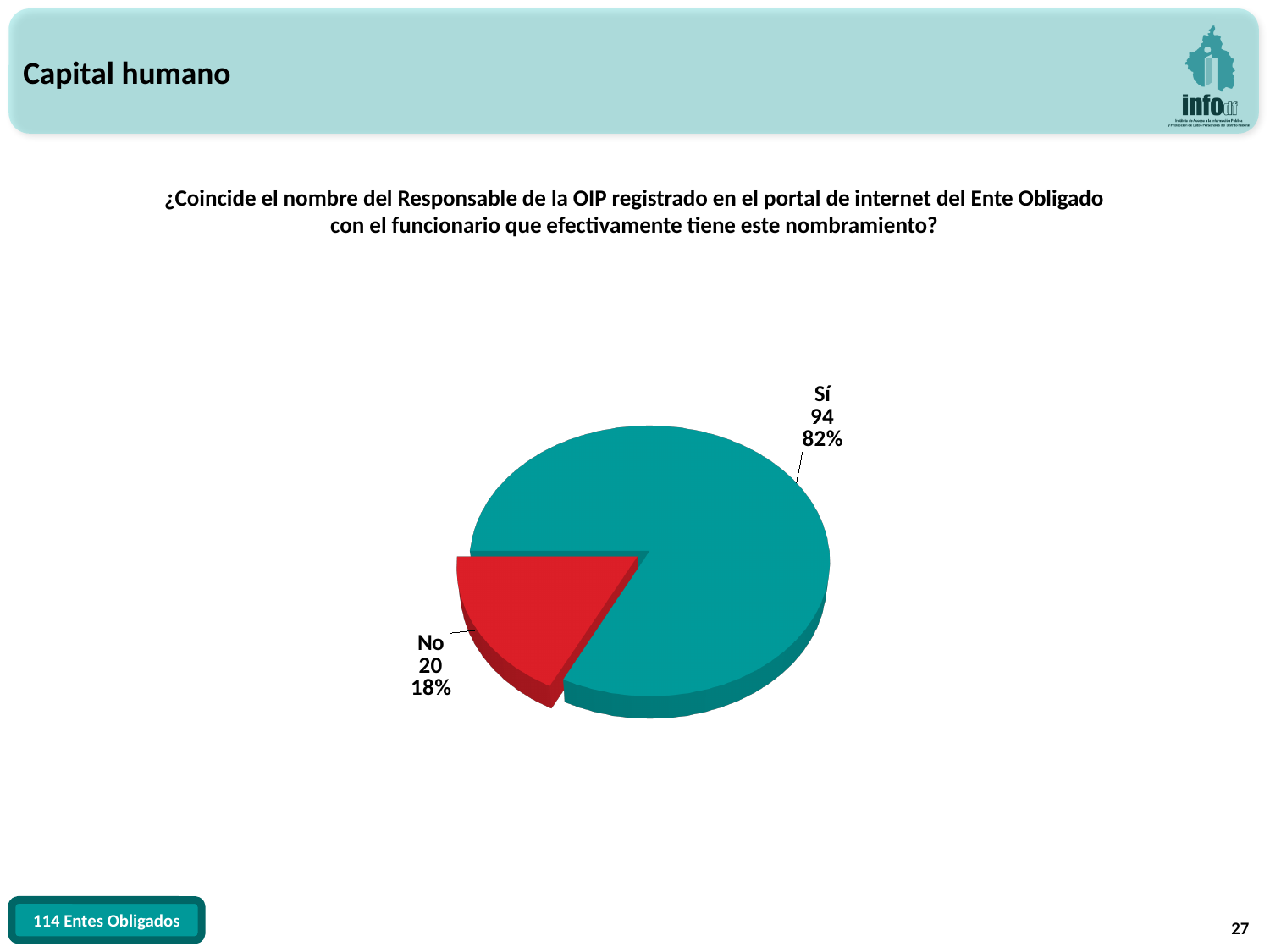
What is the value for the "Sí" slice? 94 What is the difference between the "Sí" and "No" values? 74 What is the total of the two slices? 114 What is the value for the "No" slice? 20 What share of the pie does the "No" slice represent? 18% Which is larger, the "Sí" value or the "No" value? Sí What share of the pie does the "Sí" slice represent? 82% How many slices does the pie chart have? 2 What colour is the "No" slice? red Which slice is the smallest? No What kind of chart is shown on the slide? pie chart Which slice is the largest? Sí